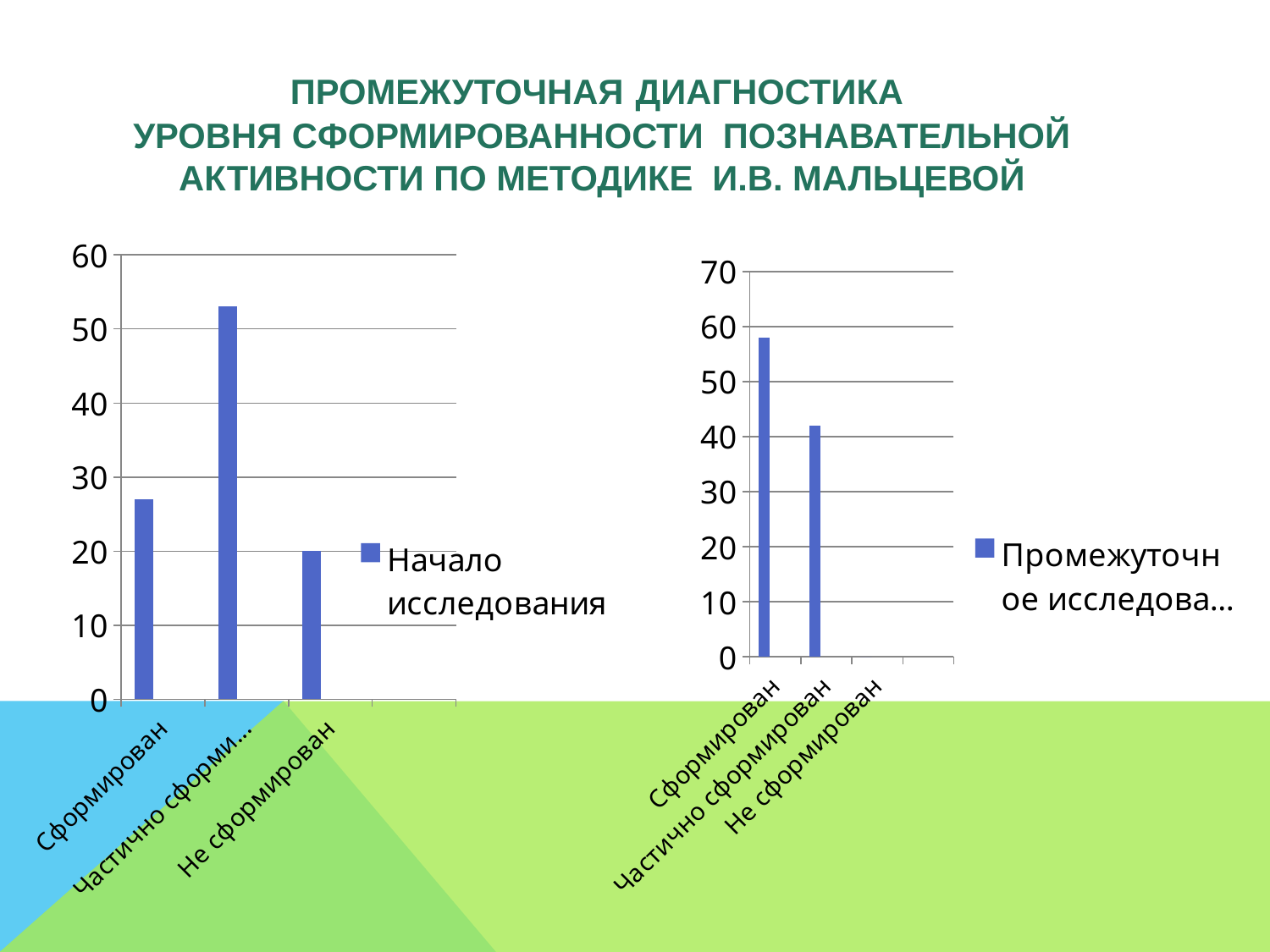
In the right chart, is the value for Сформирован greater or less than 50? greater How many series does the legend of the left chart list? 1 What is the legend entry of the left chart? Начало исследования In the left chart, is the value for Не сформирован greater or less than 30? less In the left chart, is the value for Сформирован greater or less than 30? less In the right chart, which is larger, the value for Сформирован or the value for Частично сформирован? Сформирован What kind of chart is the left chart on the slide? bar chart In the left chart, which category has the highest value? Частично сформирован In the right chart, which category has the highest value? Сформирован In the left chart, which category has the lowest value? Не сформирован